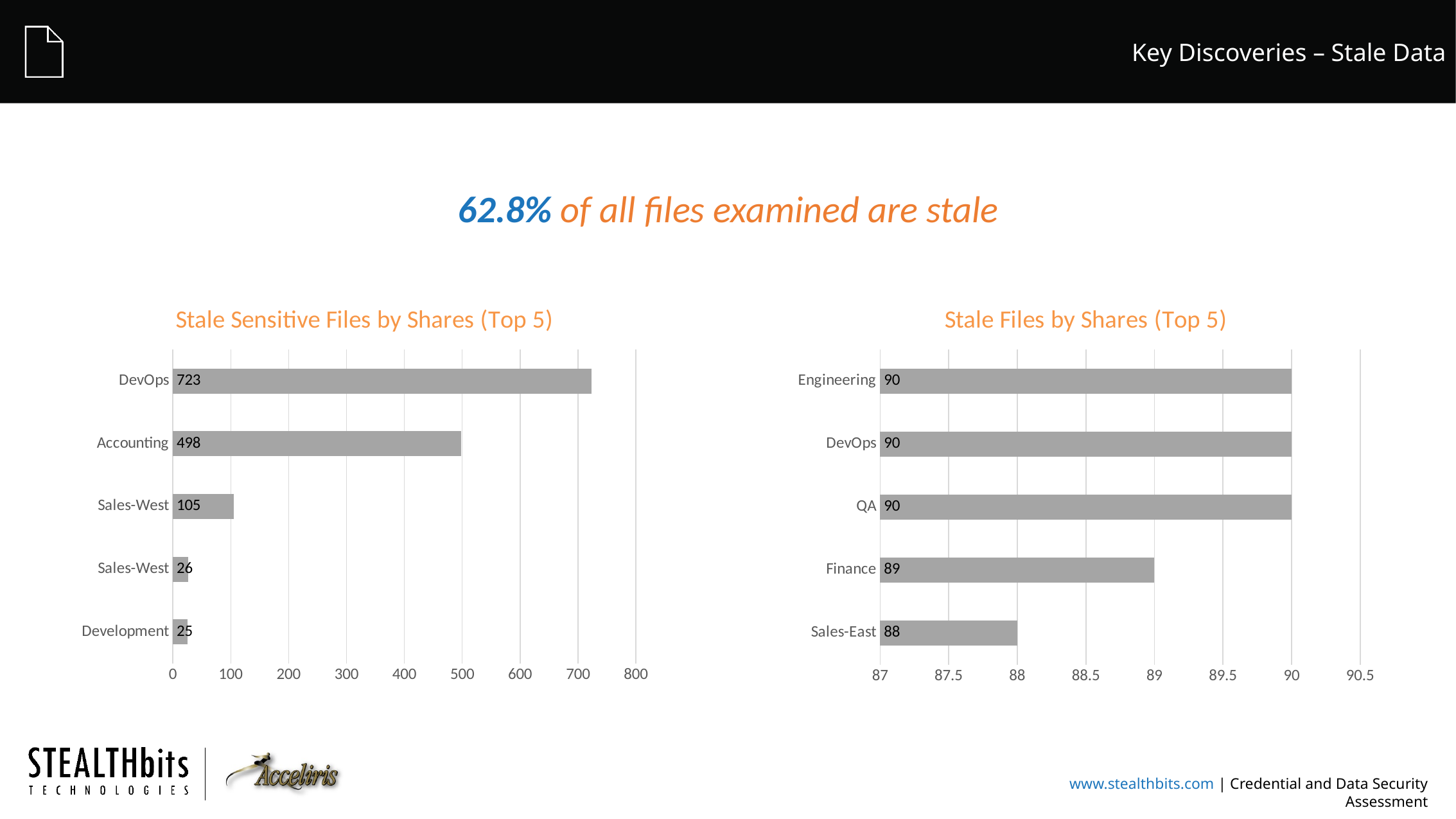
In the 'Stale Files by Shares (Top 5)' chart, what is the value for Finance? 89 In the 'Stale Sensitive Files by Shares (Top 5)' chart, which category has the highest value? DevOps In the 'Stale Sensitive Files by Shares (Top 5)' chart, how many bars are shown? 5 In the 'Stale Files by Shares (Top 5)' chart, what is the value for Sales-East? 88 In the 'Stale Sensitive Files by Shares (Top 5)' chart, what is the value for Development? 25 In the 'Stale Files by Shares (Top 5)' chart, which is larger, the value for Finance or the value for Sales-East? Finance In the 'Stale Sensitive Files by Shares (Top 5)' chart, which category has the lowest value? Development In the 'Stale Files by Shares (Top 5)' chart, which category has the lowest value? Sales-East In the 'Stale Sensitive Files by Shares (Top 5)' chart, what is the difference between the DevOps and Accounting values? 225 In the 'Stale Sensitive Files by Shares (Top 5)' chart, what is the value for Accounting? 498 What kind of chart is 'Stale Files by Shares (Top 5)'? Bar chart In the 'Stale Sensitive Files by Shares (Top 5)' chart, what is the value for DevOps? 723